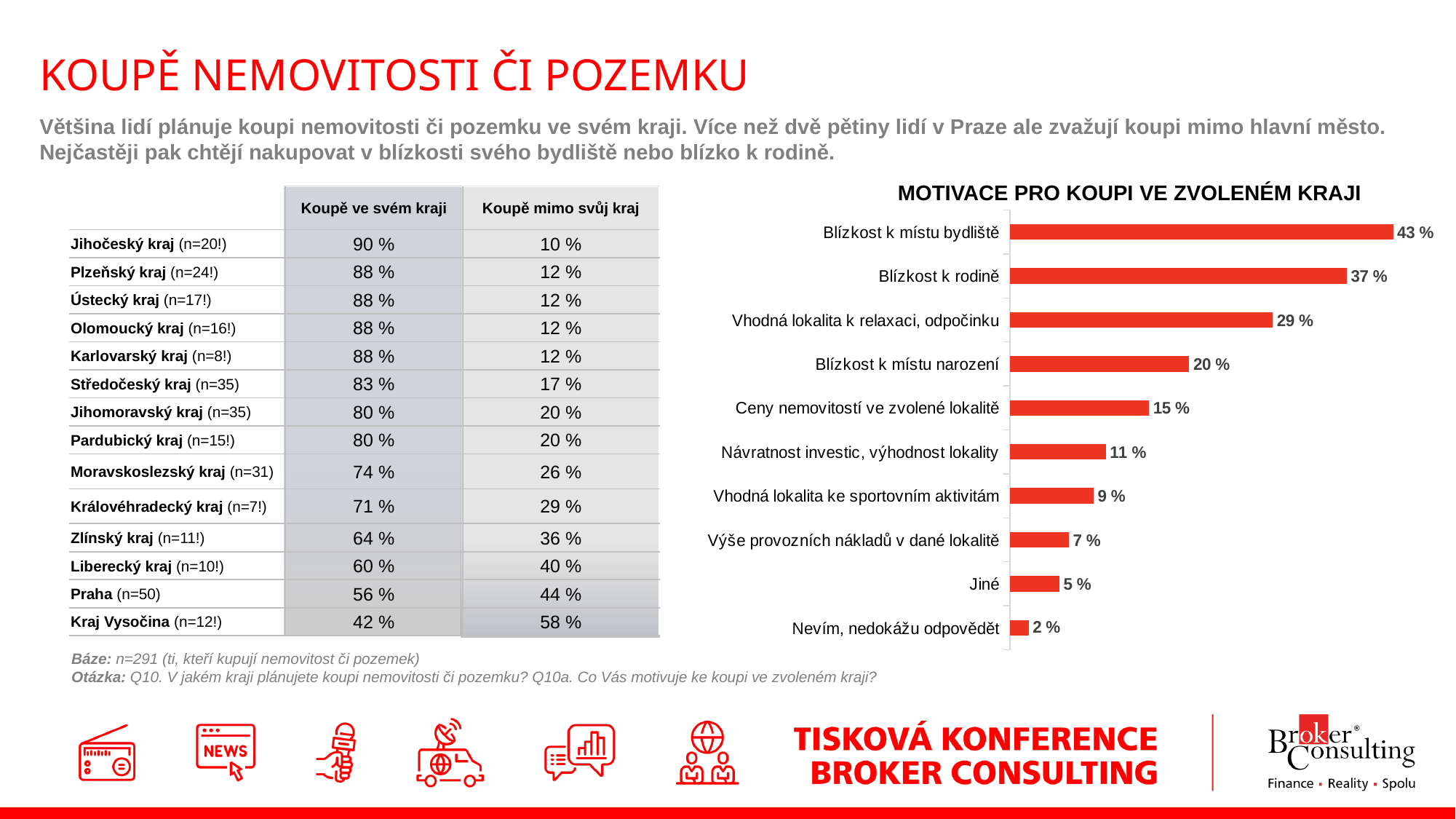
How many categories are shown in the chart? 10 Which category has the highest value in the chart? Blízkost k místu bydliště What is the difference between the values for "Blízkost k místu narození" and "Ceny nemovitostí ve zvolené lokalitě"? 5 % What colour are the bars in the chart? Red What is the value for "Vhodná lokalita k relaxaci, odpočinku" in the chart? 29 % What is the value for "Blízkost k místu bydliště" in the chart? 43 % What type of chart is shown on the slide? Bar chart Which is larger in the chart: "Vhodná lokalita ke sportovním aktivitám" or "Výše provozních nákladů v dané lokalitě"? Vhodná lokalita ke sportovním aktivitám What is the difference between the values for "Blízkost k místu bydliště" and "Blízkost k rodině"? 6 % What is the title of the chart on the slide? MOTIVACE PRO KOUPI VE ZVOLENÉM KRAJI What is the value for "Návratnost investic, výhodnost lokality" in the chart? 11 % Which category has the lowest value in the chart? Nevím, nedokážu odpovědět